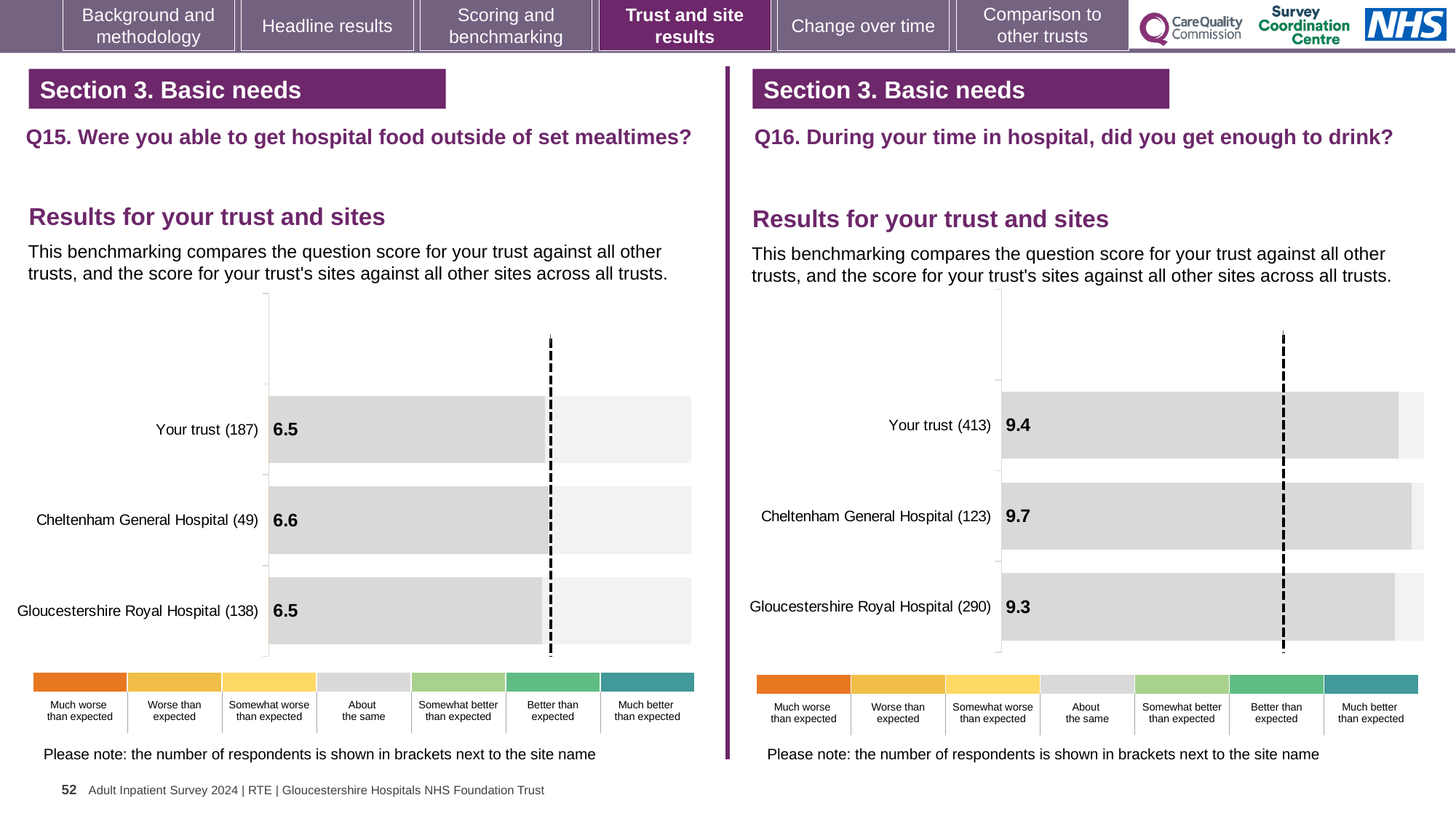
In the Q15 chart on the left, what is the score for Cheltenham General Hospital (49)? 6.6 What kind of chart is used for the Q16 results on the right? Bar chart In the Q15 chart on the left, what is the score for Your trust (187)? 6.5 In the Q16 chart on the right, what is the difference between the scores for Cheltenham General Hospital (123) and Gloucestershire Royal Hospital (290)? 0.4 In the Q16 chart on the right, what is the score for Gloucestershire Royal Hospital (290)? 9.3 In the Q16 chart on the right, which site or trust has the lowest score? Gloucestershire Royal Hospital (290) In the Q16 chart on the right, which site or trust has the highest score? Cheltenham General Hospital (123) In the Q16 chart on the right, what is the score for Your trust (413)? 9.4 In the Q15 chart on the left, which has the larger score: Cheltenham General Hospital (49) or Gloucestershire Royal Hospital (138)? Cheltenham General Hospital (49) How many bars are plotted in the Q15 chart on the left? 3 How many categories does the colour key below the Q15 chart on the left list? 7 In the Q15 chart on the left, which site or trust has the highest score? Cheltenham General Hospital (49)